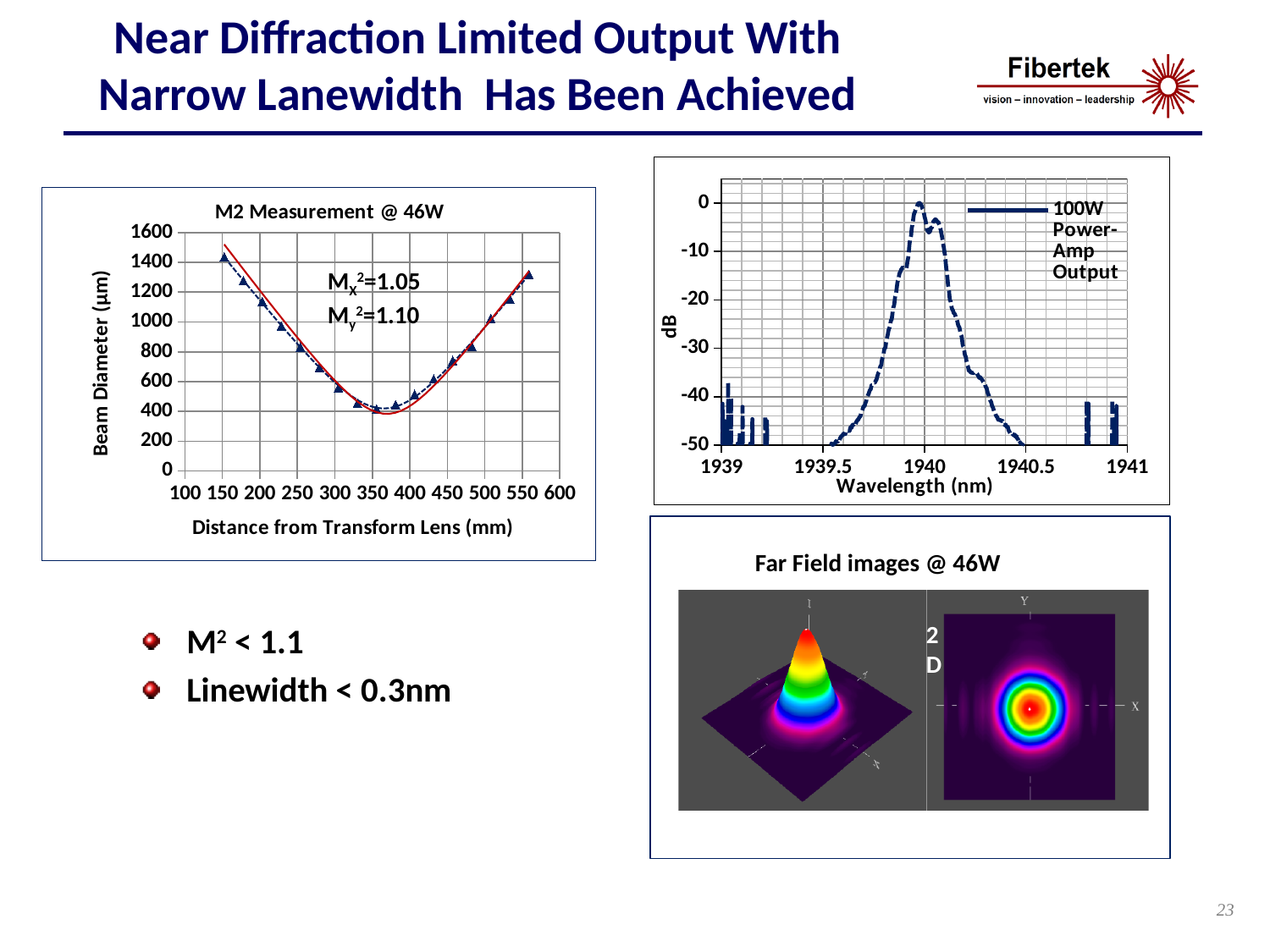
In the M2 Measurement @ 46W chart, is the smallest beam diameter greater or less than 600 μm? less In the M2 Measurement @ 46W chart, is the beam diameter at 150 mm greater or less than 1200 μm? greater In the spectrum chart on the upper right, what is the legend entry for the plotted series? 100W Power-Amp Output In the M2 Measurement @ 46W chart, does the beam diameter rise or fall as the distance increases from 150 mm to 350 mm? fall In the M2 Measurement @ 46W chart, what value of My² is annotated on the plot? 1.10 In the M2 Measurement @ 46W chart, what value of Mx² is annotated on the plot? 1.05 What is the title of the chart on the left of the slide? M2 Measurement @ 46W In the spectrum chart on the upper right, how many series does the legend list? 1 In the M2 Measurement @ 46W chart, what is the label of the y axis? Beam Diameter (μm) In the spectrum chart on the upper right, is the value at 1939.5 nm greater or less than -40 dB? less In the M2 Measurement @ 46W chart, is the beam diameter larger at 150 mm or at 350 mm? 150 mm